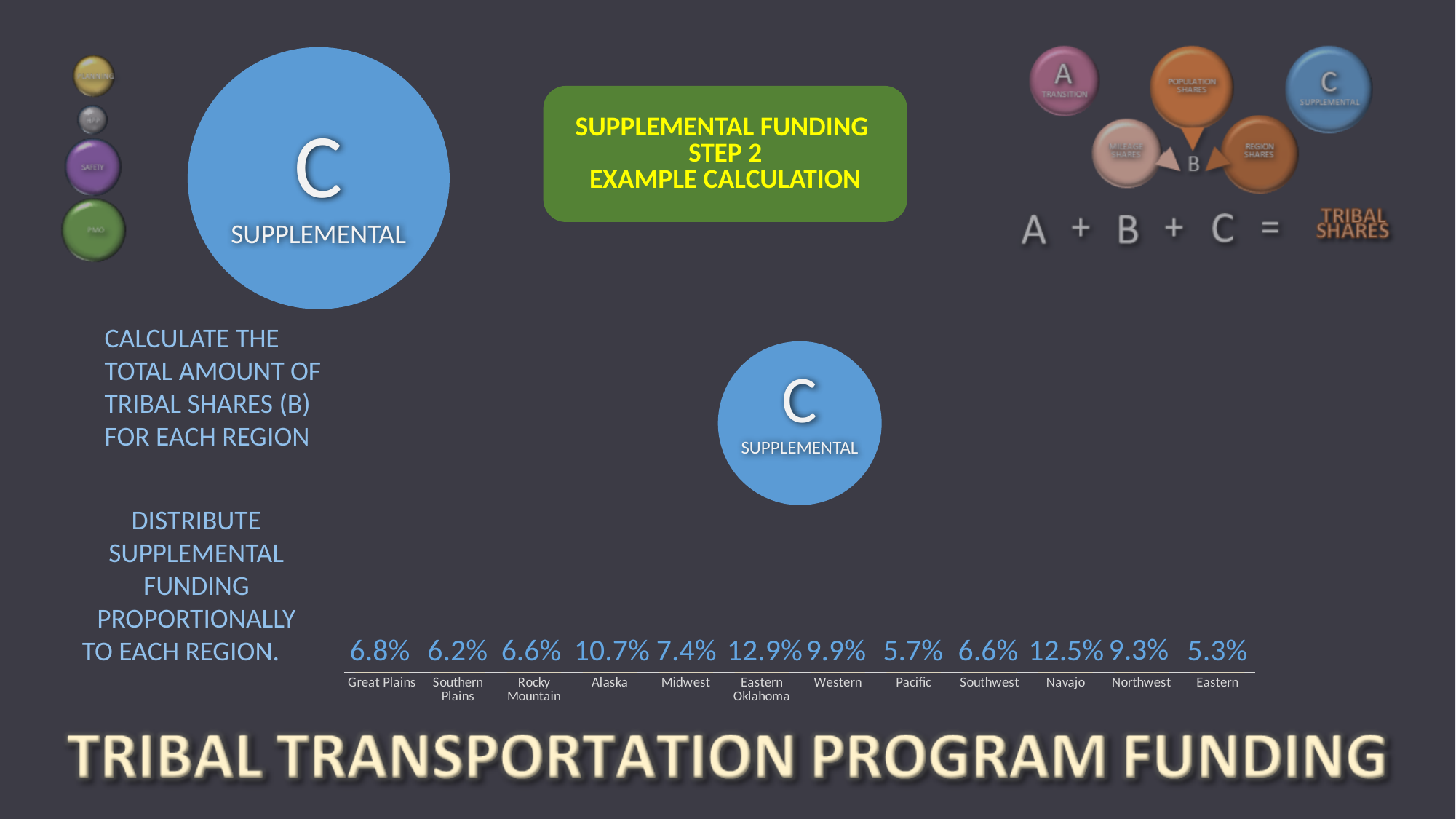
What is the value shown for Pacific? 5.7% Which region has the lowest value? Eastern Which is larger, the value for Midwest or the value for Southern Plains? Midwest What is the difference between the values for Eastern Oklahoma and Navajo? 0.4% What is the value shown for Alaska? 10.7% What is the difference between the values for Alaska and Great Plains? 3.9% How many regions are shown in the chart? 12 Which region has the highest value? Eastern Oklahoma Which two regions share the same value of 6.6%? Rocky Mountain and Southwest What is the value shown for Eastern Oklahoma? 12.9% What is the value shown for Navajo? 12.5% Which is larger, the value for Western or the value for Northwest? Western